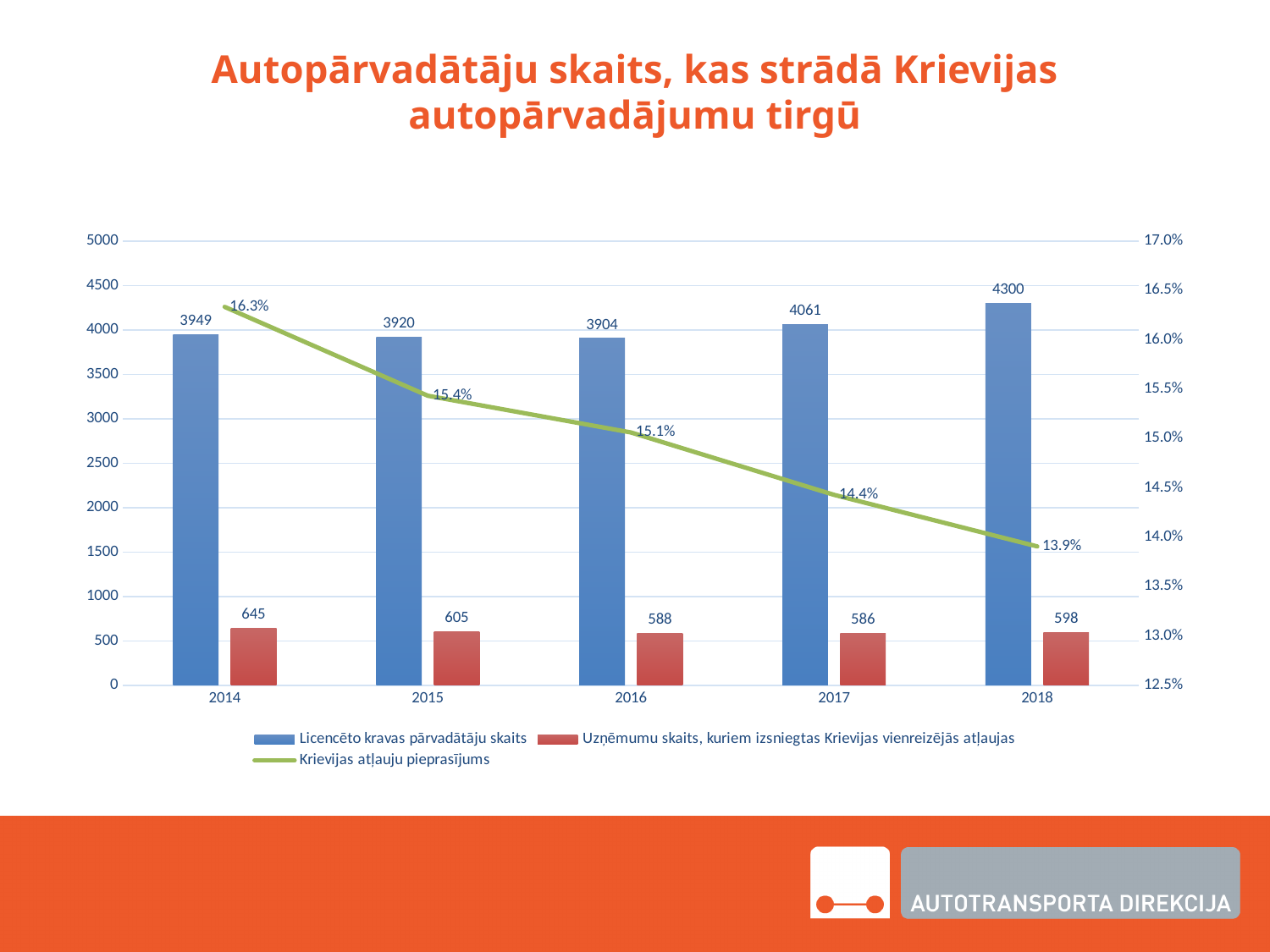
Does 'Krievijas atļauju pieprasījums' rise or fall from 2014 to 2018? Fall What is the value of 'Uzņēmumu skaits, kuriem izsniegtas Krievijas vienreizējās atļaujas' for 2014? 645 What is the value of 'Licencēto kravas pārvadātāju skaits' for 2018? 4300 What is the difference between 'Licencēto kravas pārvadātāju skaits' in 2018 and in 2017? 239 Which is larger: 'Uzņēmumu skaits, kuriem izsniegtas Krievijas vienreizējās atļaujas' in 2015 or in 2018? 2015 How many years are shown on the x axis? 5 In which year is 'Licencēto kravas pārvadātāju skaits' the lowest? 2016 Is the value of 'Licencēto kravas pārvadātāju skaits' for 2017 greater or less than 4000? greater What kind of chart is shown on the slide? Combined bar and line chart In which year is 'Uzņēmumu skaits, kuriem izsniegtas Krievijas vienreizējās atļaujas' the highest? 2014 What is the value of 'Krievijas atļauju pieprasījums' for 2016? 15.1% How many series does the legend list? 3